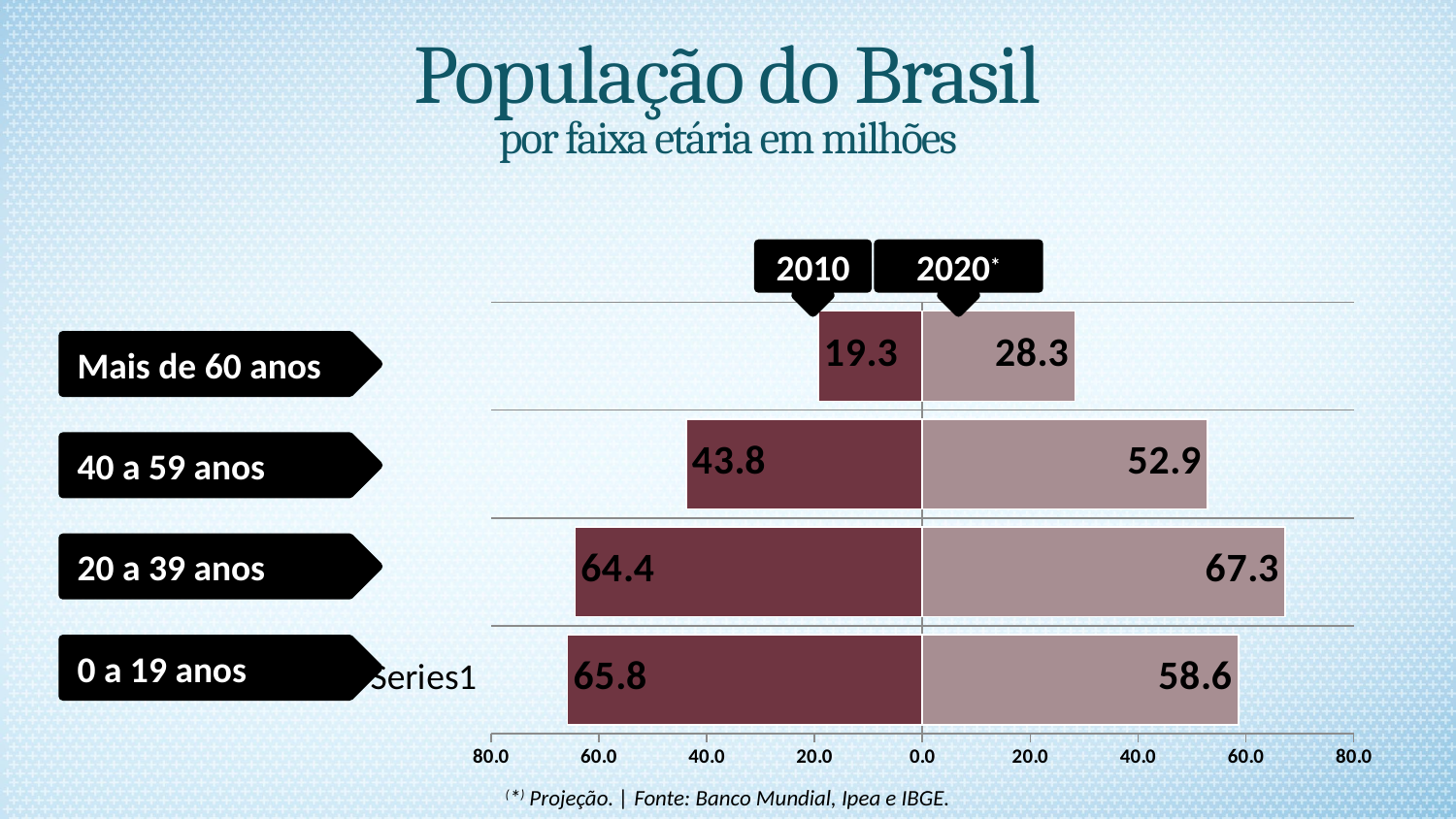
What is the difference between the 2020* and 2010 values for 'Mais de 60 anos'? 9.0 What is the title of the chart on the slide? População do Brasil por faixa etária em milhões What is the 2010 value for the 'Mais de 60 anos' age group? 19.3 How many series does the chart show? 2 Which age group has the lowest 2020* value? Mais de 60 anos What kind of chart is shown on the slide? Bar chart What is the 2020* value for the '40 a 59 anos' age group? 52.9 For the '20 a 39 anos' group, which is larger: the 2010 value or the 2020* value? 2020* Which age group has the highest 2010 value? 0 a 19 anos What is the difference between the 2010 and 2020* values for '0 a 19 anos'? 7.2 How many age groups are shown in the chart? 4 What is the 2020* value for the '0 a 19 anos' age group? 58.6